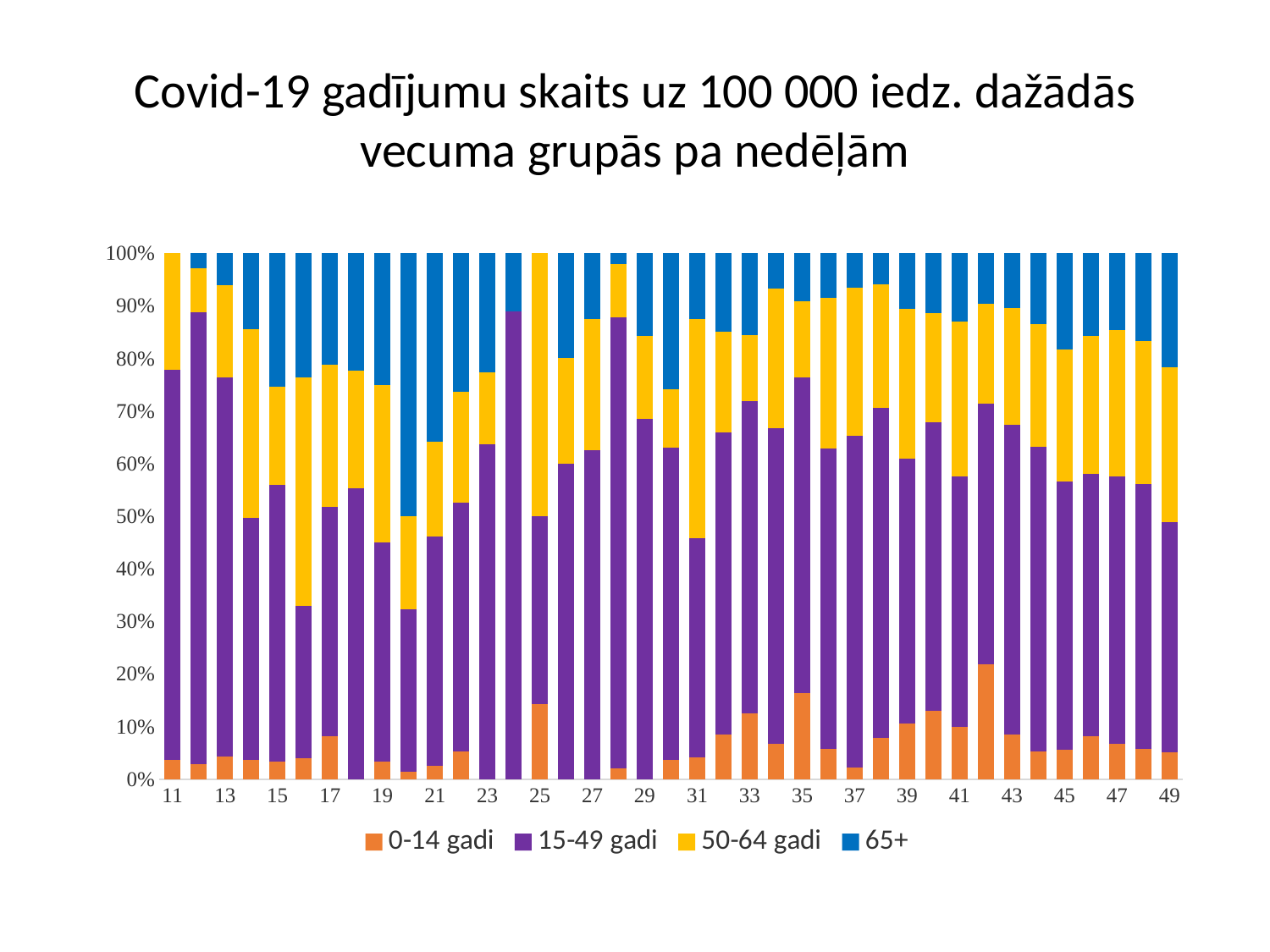
Which week has the largest share for the 0-14 gadi group? 42 What kind of chart is shown on the slide? stacked bar chart Which week has the largest share for the 65+ group? 20 How many weeks (bars) are plotted on the x axis? 39 Is the share of the 0-14 gadi group in week 43 greater or less than 15%? less How many series does the legend list? 4 Is the share of the 15-49 gadi group in week 24 greater or less than 80%? greater What is the title of the chart? Covid-19 gadījumu skaits uz 100 000 iedz. dažādās vecuma grupās pa nedēļām Which series is shown in blue? 65+ Is the share of the 0-14 gadi group in week 25 greater or less than 10%? greater Which week has the larger share for the 0-14 gadi group, week 11 or week 43? 43 Which week has the larger share for the 65+ group, week 12 or week 20? 20